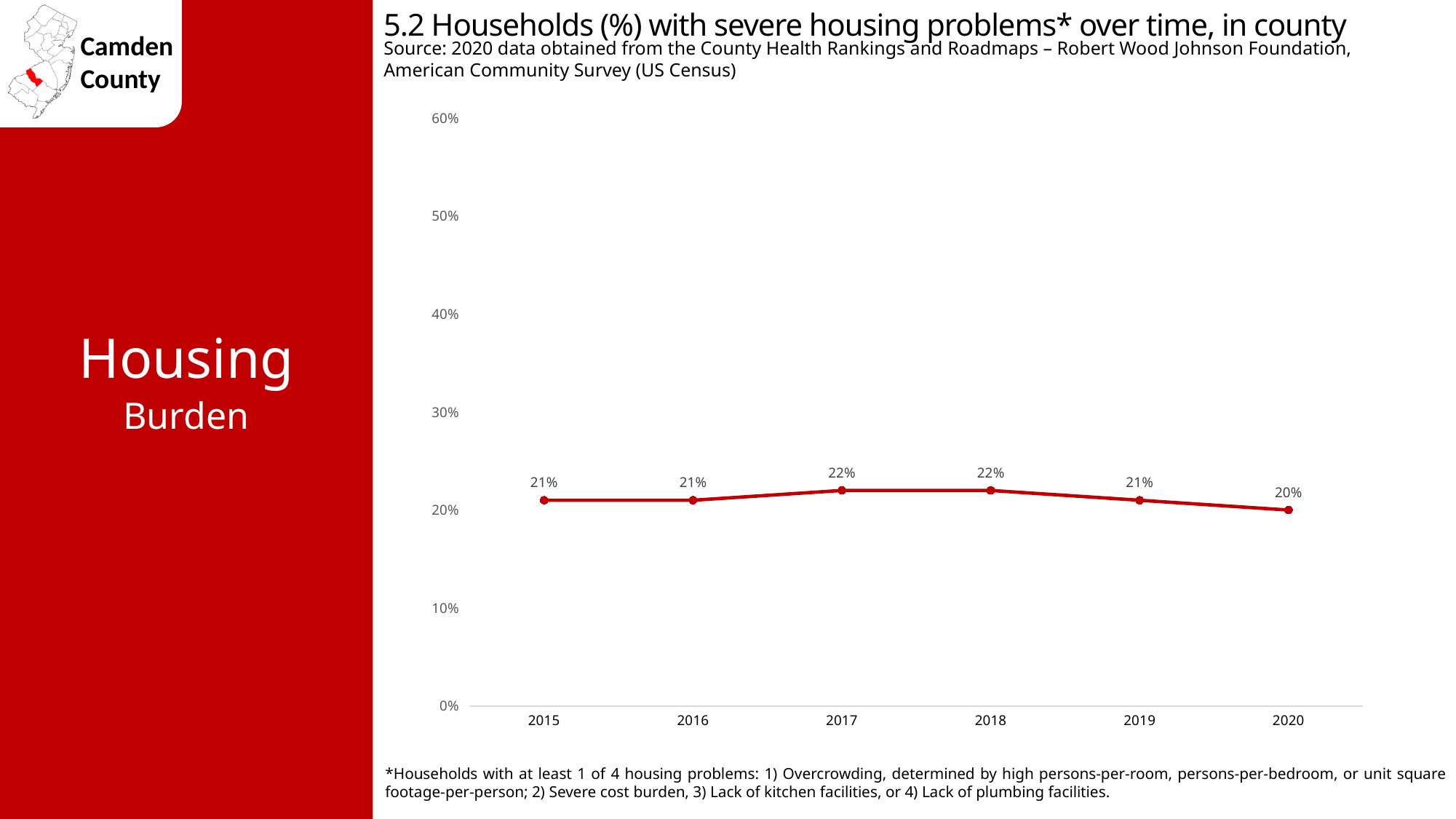
What percentage of households had severe housing problems in 2020? 20% What percentage of households had severe housing problems in 2019? 21% Is the value for 2017 larger or smaller than the value for 2020? larger Is the value for 2018 greater or less than 30%? less What is the title of the chart? 5.2 Households (%) with severe housing problems* over time, in county What percentage of households had severe housing problems in 2015? 21% What is the difference between the 2018 value and the 2020 value? 2% What percentage of households had severe housing problems in 2017? 22% Which year shows the lowest percentage of households with severe housing problems? 2020 How many years are plotted on the chart? 6 Does the percentage rise or fall from 2018 to 2020? fall What kind of chart is shown on the slide? line chart